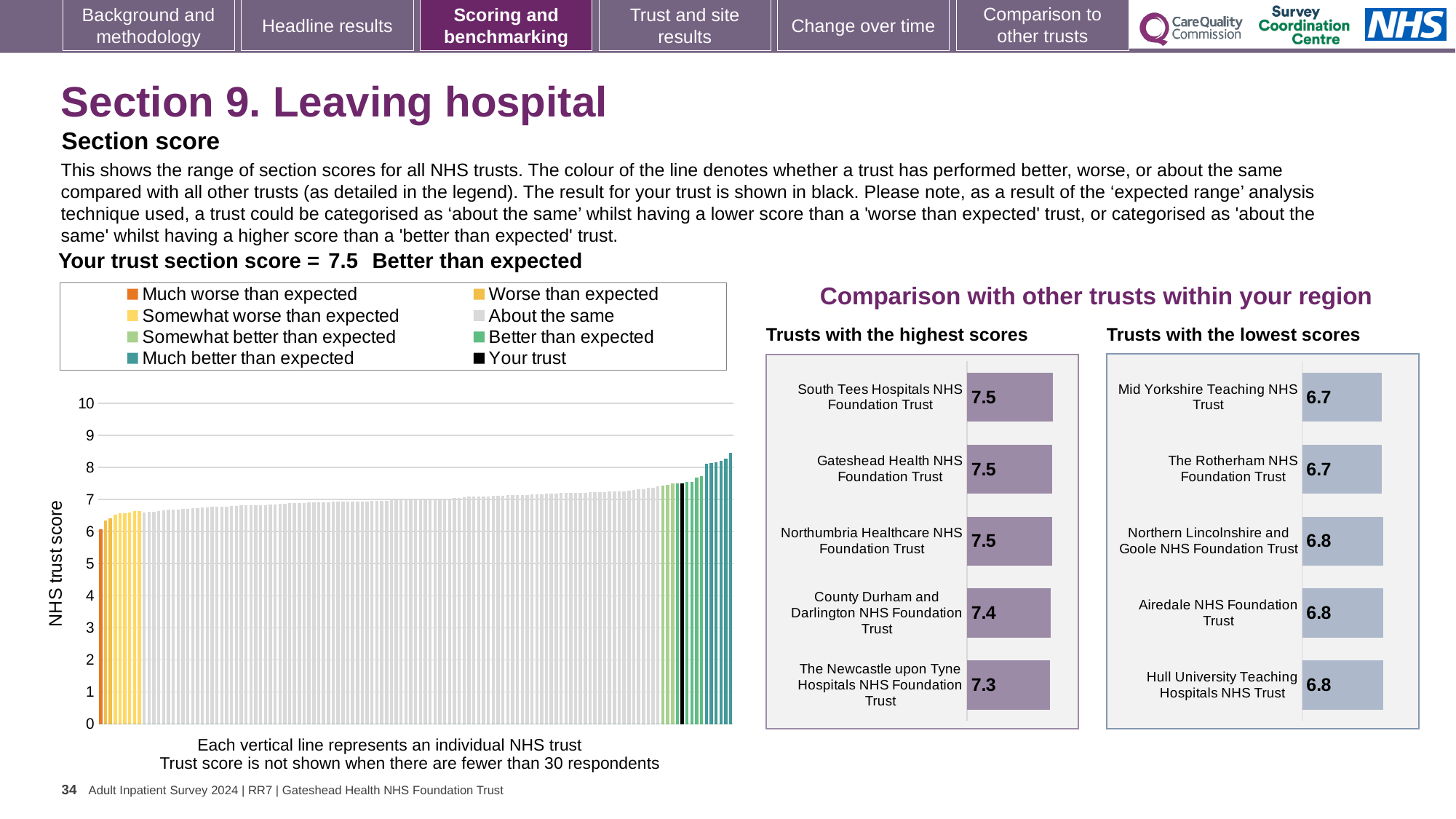
In the 'Trusts with the lowest scores' chart, what is the score for Airedale NHS Foundation Trust? 6.8 In the 'Trusts with the highest scores' chart, which has the higher score: County Durham and Darlington NHS Foundation Trust or The Newcastle upon Tyne Hospitals NHS Foundation Trust? County Durham and Darlington NHS Foundation Trust How many trusts are shown in the 'Trusts with the lowest scores' chart? 5 In the main chart on the left showing all NHS trusts, do the bar values rise or fall from left to right? rise In the main chart on the left showing all NHS trusts, is the value of the leftmost (orange) bar greater or less than 7? less In the 'Trusts with the highest scores' chart, what is the difference between the score for South Tees Hospitals NHS Foundation Trust and The Newcastle upon Tyne Hospitals NHS Foundation Trust? 0.2 In the 'Trusts with the highest scores' chart, what is the score for The Newcastle upon Tyne Hospitals NHS Foundation Trust? 7.3 In the 'Trusts with the highest scores' chart, what is the score for County Durham and Darlington NHS Foundation Trust? 7.4 How many entries does the legend of the main chart on the left list? 8 In the 'Trusts with the lowest scores' chart, which trust has the lowest score listed first? Mid Yorkshire Teaching NHS Trust In the 'Trusts with the highest scores' chart, which trust has the lowest score? The Newcastle upon Tyne Hospitals NHS Foundation Trust In the 'Trusts with the lowest scores' chart, what is the difference between the score for Hull University Teaching Hospitals NHS Trust and Mid Yorkshire Teaching NHS Trust? 0.1